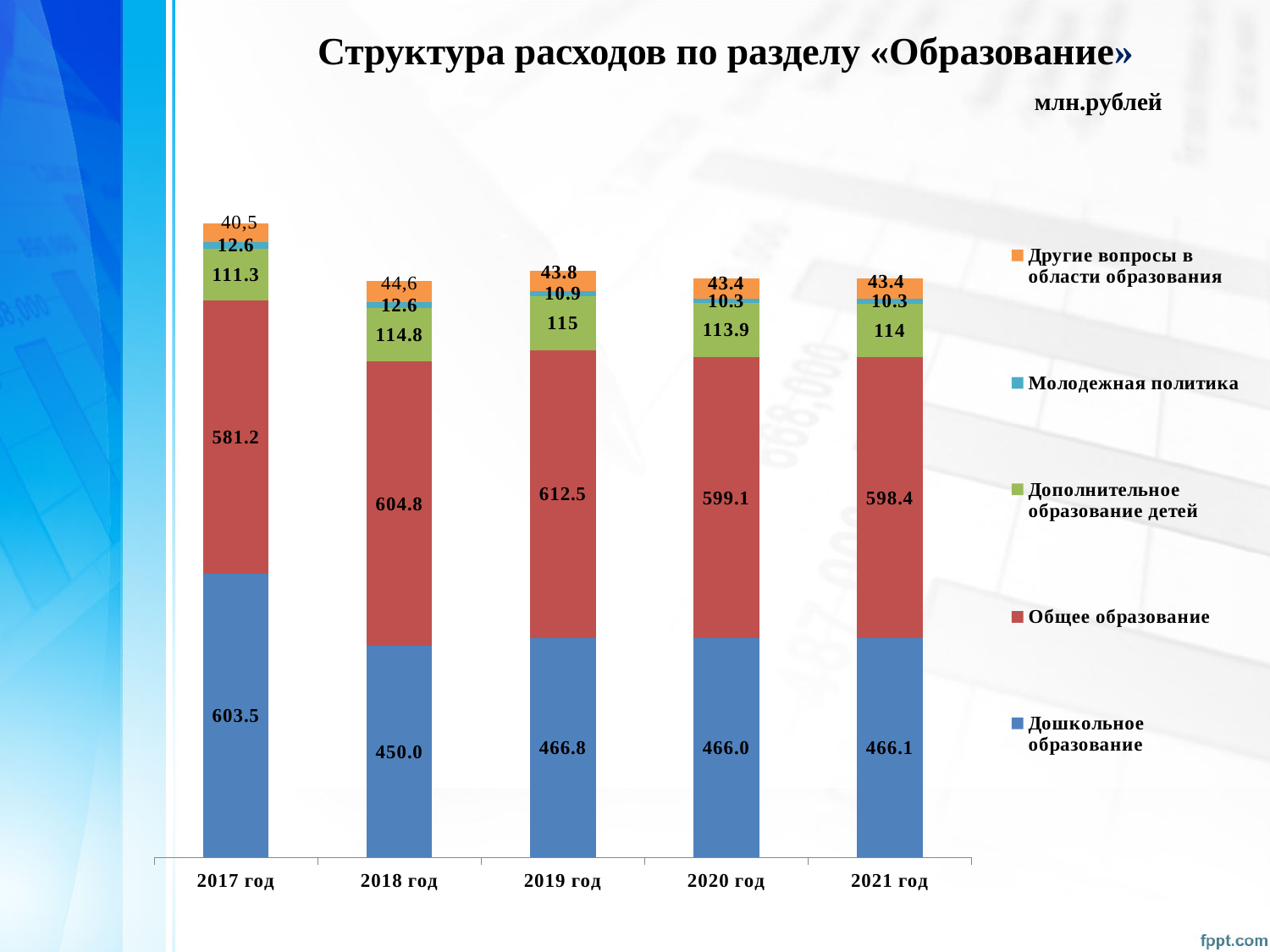
What is the difference between Общее образование in 2019 год and in 2017 год? 31.3 In 2017 год, which is larger: Дошкольное образование or Общее образование? Дошкольное образование In which year is Дошкольное образование the lowest? 2018 год What is the value for Дошкольное образование in 2017 год? 603.5 What is the value for Молодежная политика in 2021 год? 10.3 What is the value for Общее образование in 2019 год? 612.5 How many series does the legend list? 5 How many years are shown on the x axis? 5 What is the value for Дополнительное образование детей in 2020 год? 113.9 What kind of chart is shown on the slide? Stacked bar chart In which year is Общее образование the highest? 2019 год What is the total of the stacked bar for 2019 год? 1249.0